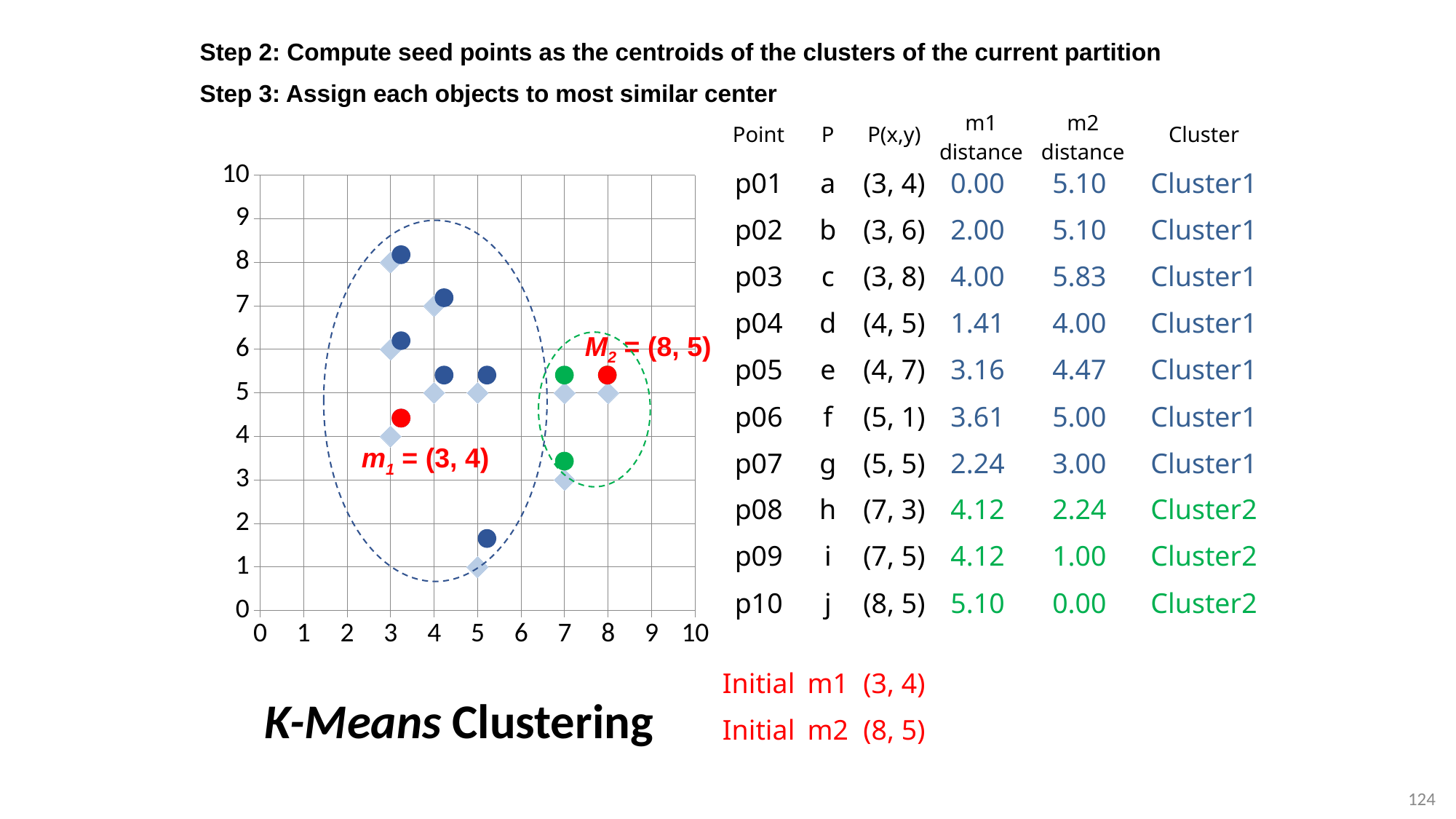
Which point has the highest y value on the chart? c (3, 8) How many data points (a through j) are plotted on the chart? 10 Which point has the lowest y value on the chart? f (5, 1) What are the coordinates of the seed point m1 labelled on the chart? (3, 4) Is the y value of point f greater or less than 2? less What is the difference between the y value of point c and the y value of point f? 7 Which point has the larger x value, point j or point a? j How many points are enclosed by the green dashed ellipse (Cluster2)? 3 What are the coordinates of the seed point M2 labelled on the chart? (8, 5) What kind of chart is shown on the slide? scatter chart What colour is the dashed ellipse drawn around Cluster2 on the chart? green What is the maximum value shown on the x axis of the chart? 10